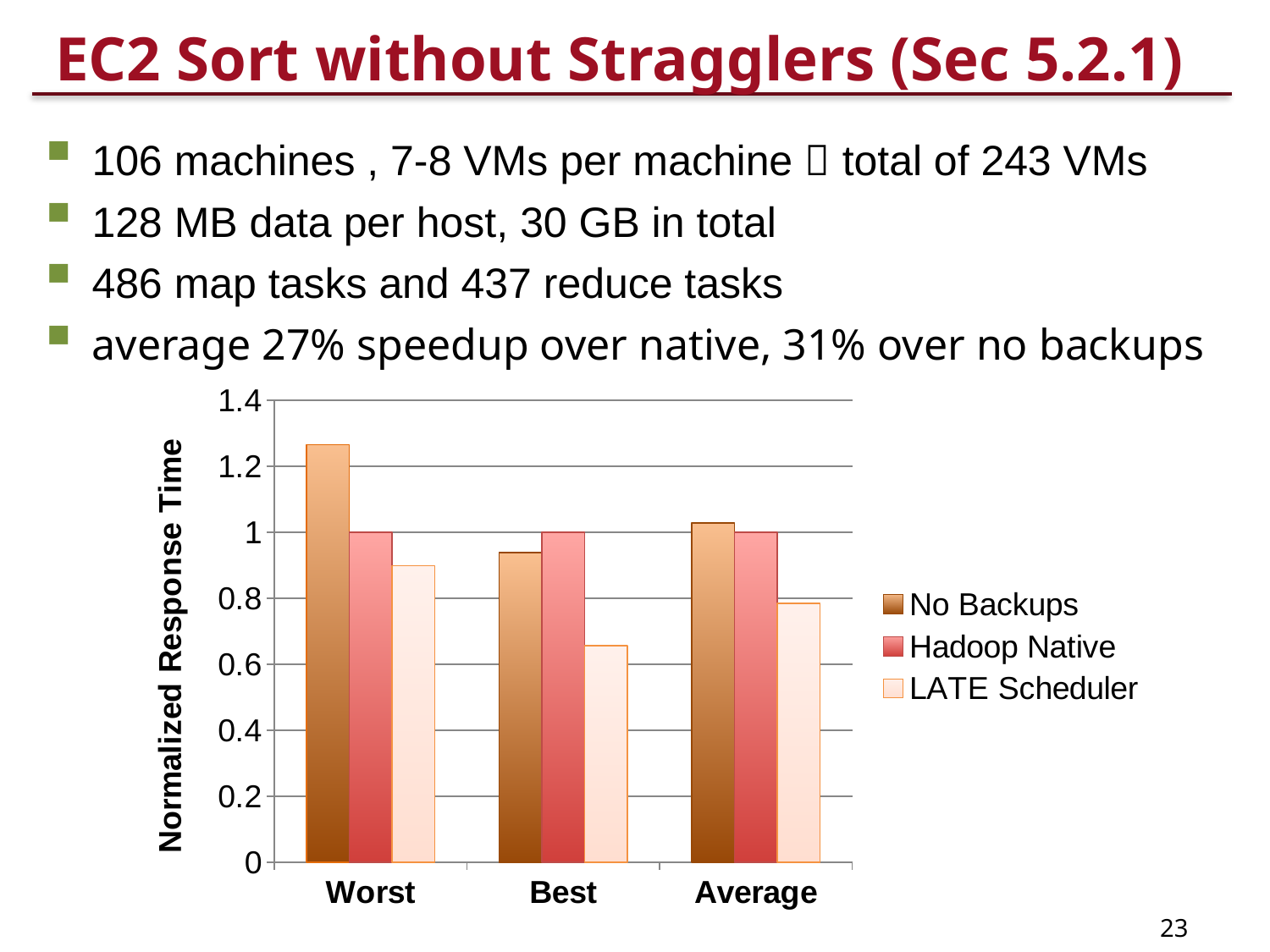
How many series does the chart's legend list? 3 What is the value for Hadoop Native in the Average category? 1 Is the value for No Backups in the Worst category greater or less than 1.2? greater What kind of chart is shown on the slide? bar chart What is the value for Hadoop Native in the Worst category? 1 Is the value for LATE Scheduler in the Worst category greater or less than 1? less Is the value for No Backups in the Best category greater or less than 1? less How many categories are shown on the x axis of the chart? 3 Which series has the lowest value in the Best category? LATE Scheduler What is the title of the chart's vertical axis? Normalized Response Time Which series has the highest value in the Worst category? No Backups